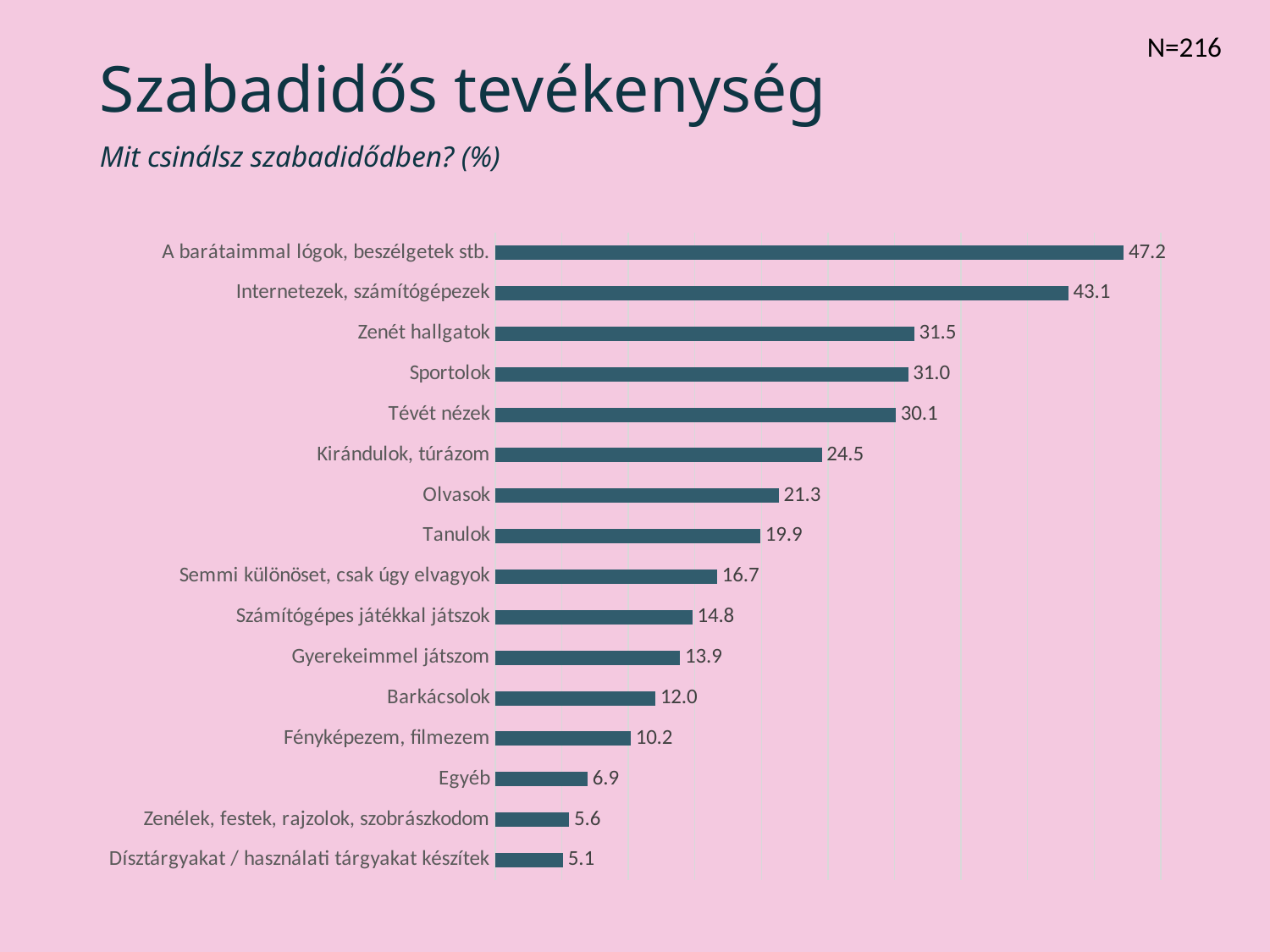
Which category has the highest value? A barátaimmal lógok, beszélgetek stb. What is the difference between the values for "A barátaimmal lógok, beszélgetek stb." and "Internetezek, számítógépezek"? 4.1 What is the difference between the values for "Olvasok" and "Tanulok"? 1.4 What is the subtitle question shown above the chart? Mit csinálsz szabadidődben? (%) Which is larger, the value for "Tévét nézek" or the value for "Kirándulok, túrázom"? Tévét nézek What is the value for "Kirándulok, túrázom"? 24.5 How many categories are shown in the chart? 16 What is the value for "Internetezek, számítógépezek"? 43.1 What is the value for "Barkácsolok"? 12.0 Which category has the lowest value? Dísztárgyakat / használati tárgyakat készítek What kind of chart is shown on the slide? Bar chart Which is larger, the value for "Egyéb" or the value for "Fényképezem, filmezem"? Fényképezem, filmezem